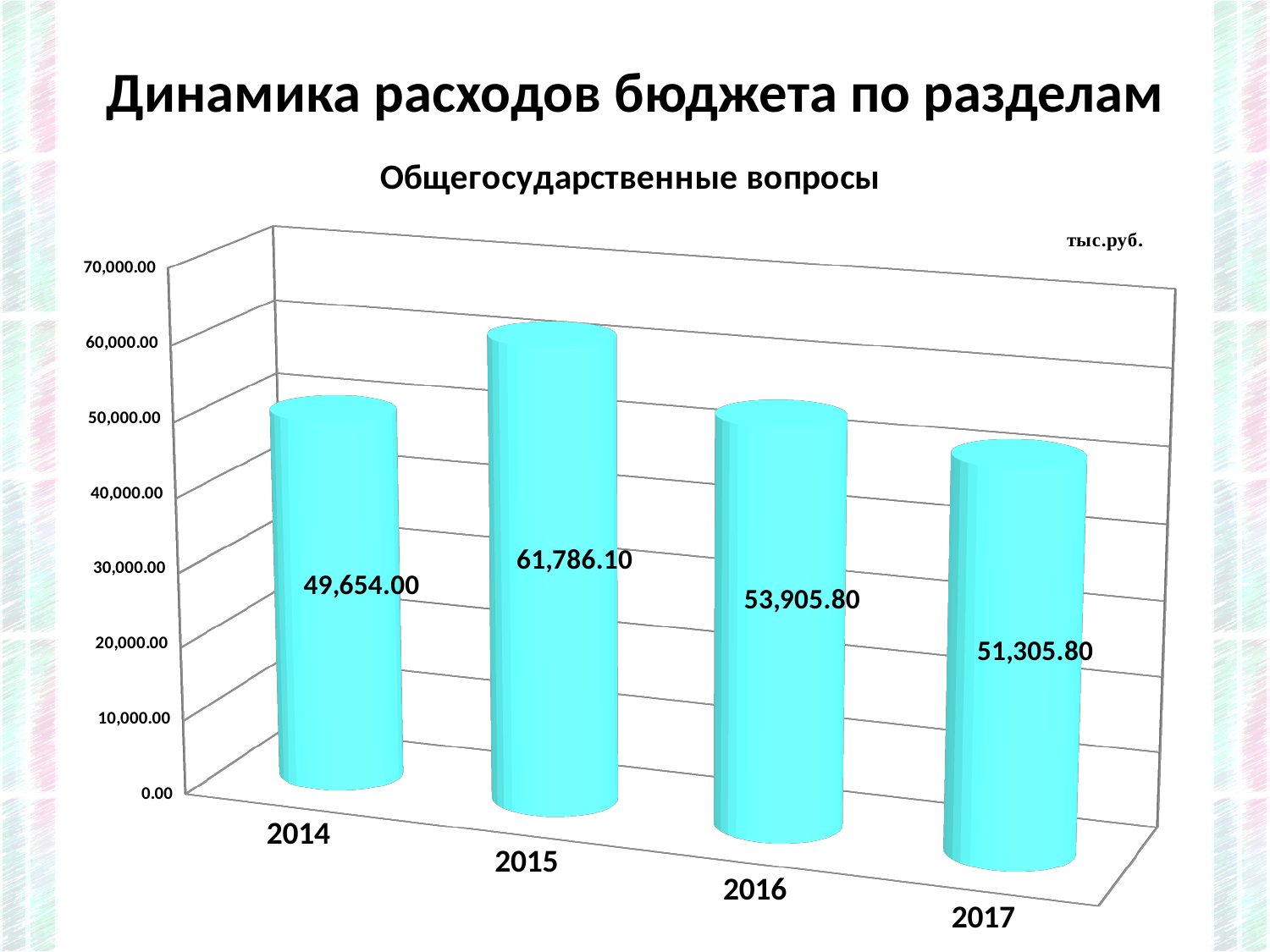
How many years are shown on the x axis? 4 From 2015 to 2017, do the values rise or fall? fall What is the value for 2015? 61,786.10 Which year has the highest value? 2015 What is the difference between the values for 2016 and 2017? 2,600.00 What is the value for 2014? 49,654.00 What kind of chart is this? bar chart Which year has the lowest value? 2014 What is the value for 2017? 51,305.80 What is the difference between the values for 2015 and 2014? 12,132.10 Which is larger, the value for 2016 or the value for 2017? 2016 What is the value for 2016? 53,905.80